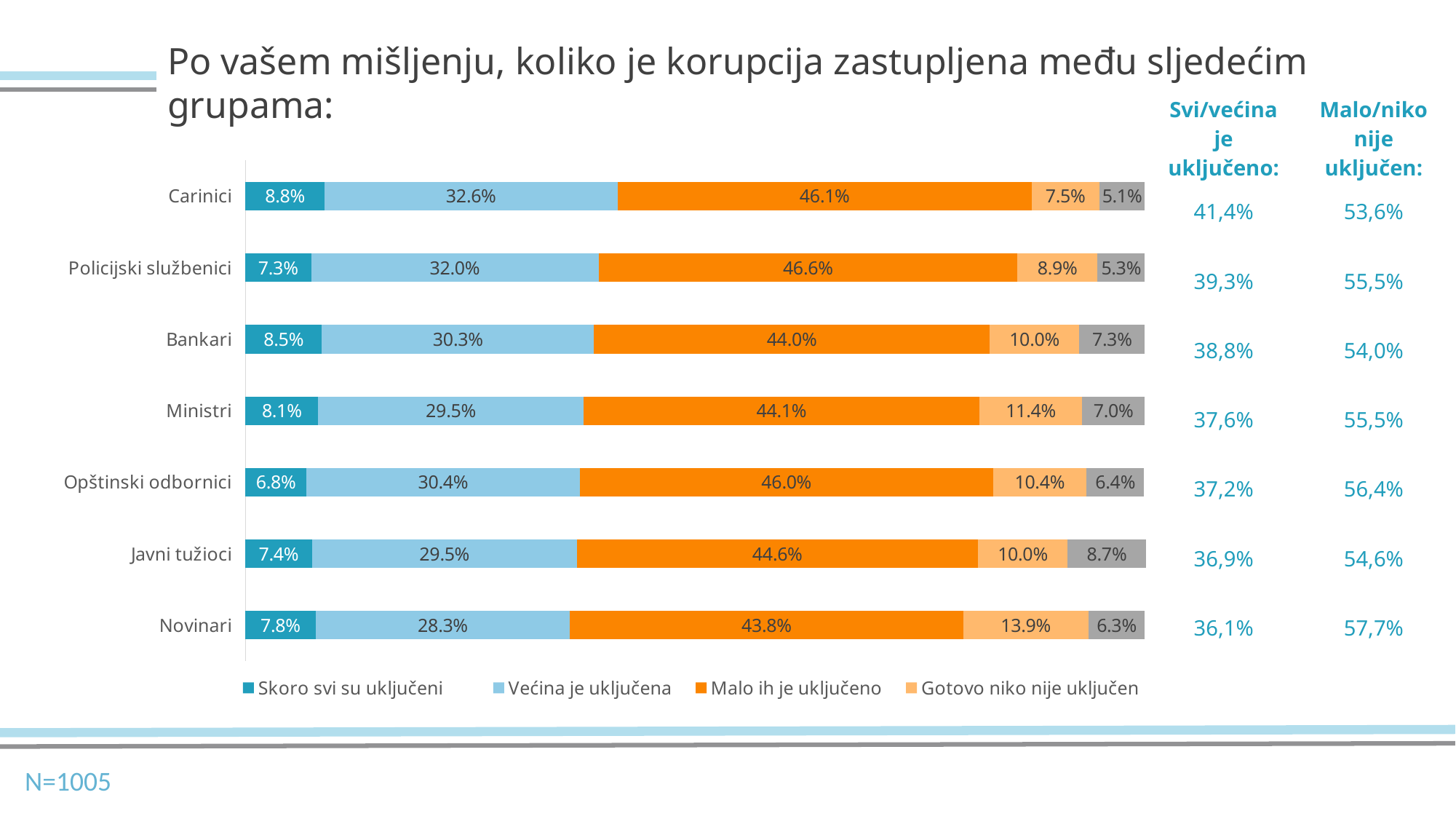
What is the value of "Gotovo niko nije uključen" for Novinari? 13.9% How many groups are shown in the chart? 7 What is the value of "Većina je uključena" for Ministri? 29.5% How many series does the legend list? 4 Which has a larger "Malo ih je uključeno" value: Policijski službenici or Bankari? Policijski službenici What is the difference between the "Većina je uključena" values for Carinici and Novinari? 4.3 percentage points What is the value of "Malo ih je uključeno" for Carinici? 46.1% What type of chart is shown on the slide? Stacked bar chart Which group has the lowest value for "Skoro svi su uključeni"? Opštinski odbornici Which group has the highest value for "Skoro svi su uključeni"? Carinici What is the sample size shown on the slide? N=1005 Which group has the highest value for "Gotovo niko nije uključen"? Novinari